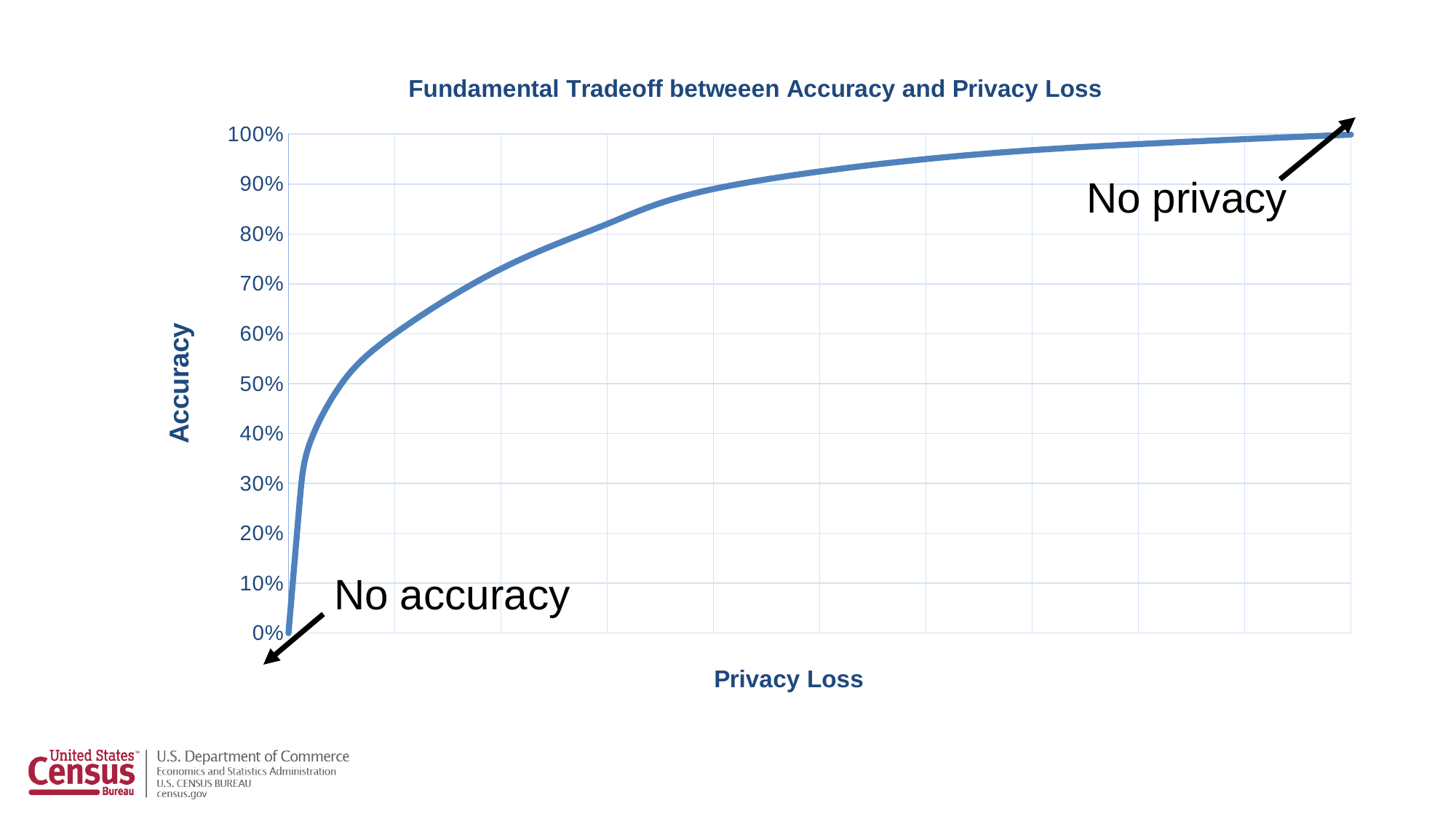
What is the lowest value shown on the Accuracy axis? 0% As privacy loss increases along the x axis, does accuracy rise or fall? rise What is the label of the vertical axis? Accuracy What kind of chart is shown on the slide? line chart What accuracy value does the curve start at on the far left of the chart? 0% Is the accuracy at the point labelled 'No privacy' greater or less than 90%? greater Which end of the curve has higher accuracy, the 'No accuracy' end or the 'No privacy' end? No privacy What is the highest value shown on the Accuracy axis? 100% How many lines are plotted on the chart? 1 Is the accuracy at the point labelled 'No accuracy' greater or less than 10%? less What is the title of the chart? Fundamental Tradeoff betweeen Accuracy and Privacy Loss